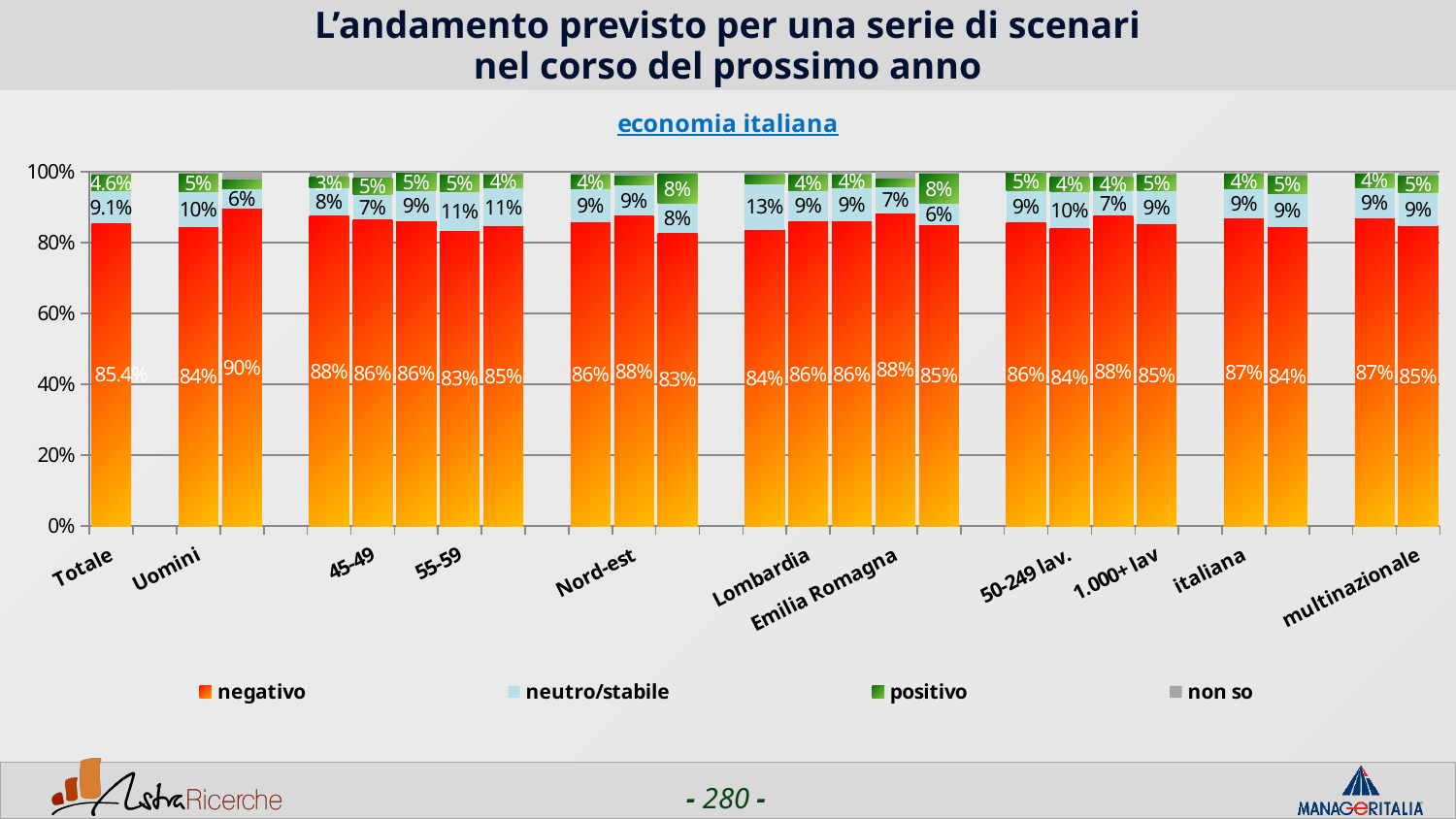
Is the 'negativo' value for 1.000+ lav greater or less than 80%? greater What is the 'neutro/stabile' value for Uomini? 10% What is the 'neutro/stabile' value for 55-59? 11% Which is larger, the 'negativo' value for Nord-est or for 55-59? Nord-est What is the subtitle shown above the chart? economia italiana What kind of chart is shown on the slide? stacked bar chart What is the difference between the 'negativo' value for Nord-est and for 55-59? 5% How many series does the legend list? 4 What is the 'negativo' value for Nord-est? 88% What is the 'negativo' value for Totale? 85.4% What is the 'negativo' value for Emilia Romagna? 88% What is the 'positivo' value for multinazionale? 5%